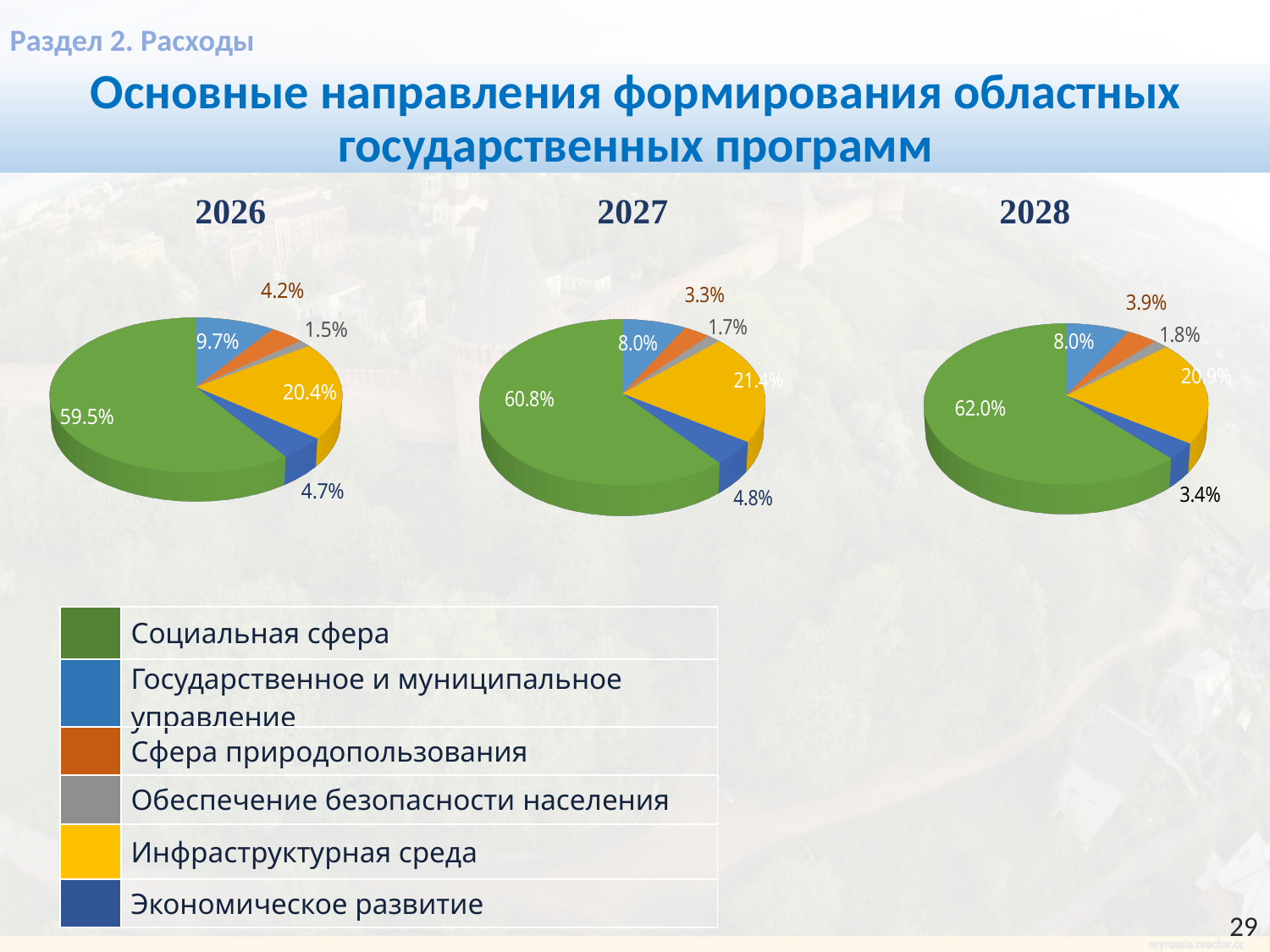
In the 2027 pie chart, which category has the smallest share? Обеспечение безопасности населения Which colour represents Сфера природопользования in the legend? Orange How many slices does the 2028 pie chart have? 6 In the 2028 pie chart, what share does Экономическое развитие have? 3.4% How many categories does the legend list? 6 In the 2026 pie chart, what share does Социальная сфера have? 59.5% In the 2027 pie chart, which is larger: the share of Сфера природопользования or the share of Экономическое развитие? Экономическое развитие In the 2028 pie chart, which category has the largest share? Социальная сфера In the 2027 pie chart, what share does Инфраструктурная среда have? 21.4% In the 2026 pie chart, what share does Государственное и муниципальное управление have? 9.7% In the 2026 pie chart, what is the difference between the shares of Инфраструктурная среда and Государственное и муниципальное управление? 10.7% What type of chart is used for 2026, 2027 and 2028? Pie chart